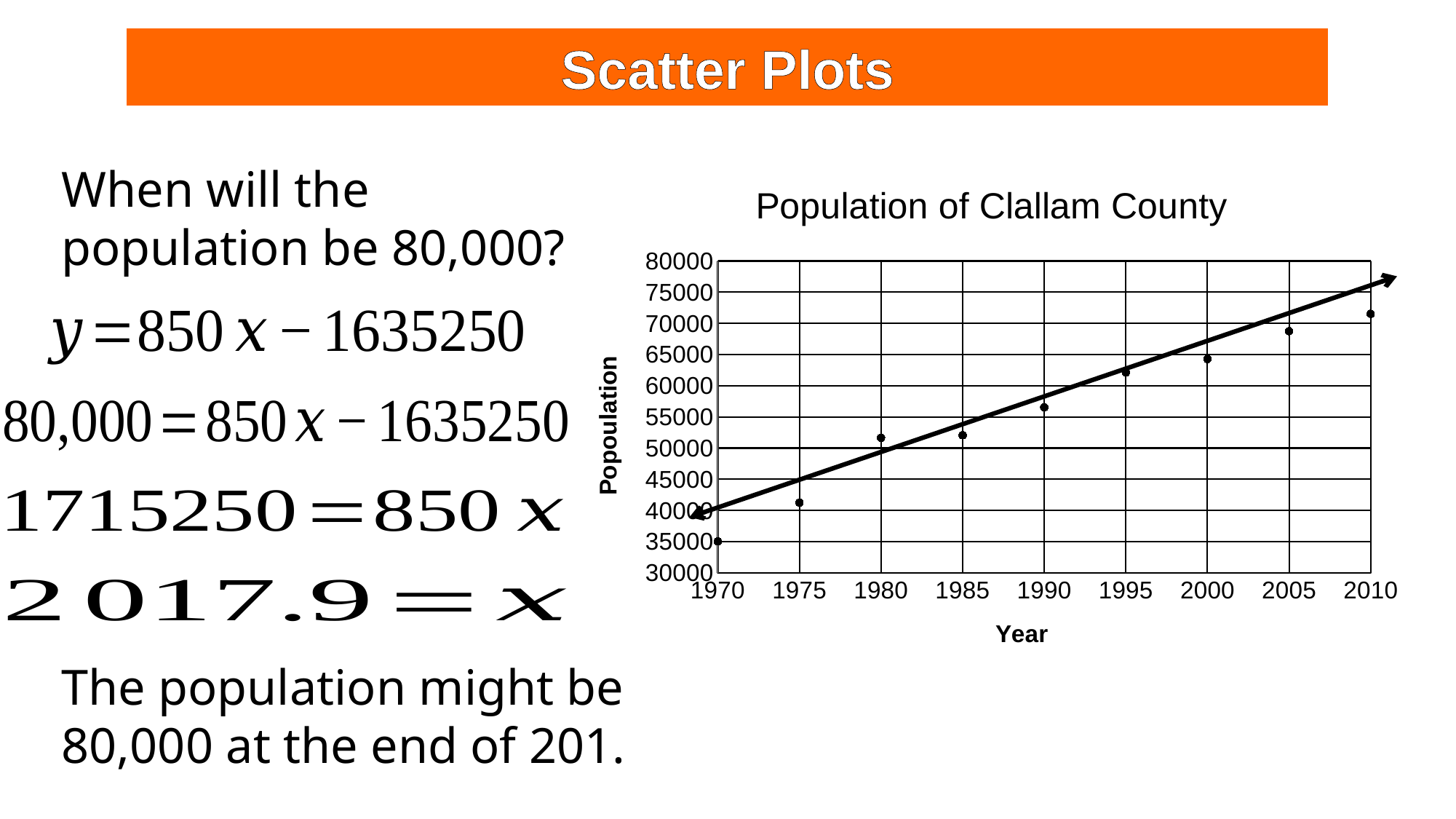
What is the title of the chart? Population of Clallam County Do the plotted population values rise or fall from 1970 to 2010? Rise What kind of chart is shown on the slide? Scatter plot How many data points are plotted on the chart? 9 What is the label of the x axis of the chart? Year Is the population value for 2010 greater or less than 70000? greater Is the population value for 1985 greater or less than 55000? less Is the population value for 1975 greater or less than 40000? greater Which year has the highest plotted population? 2010 Which year has the larger plotted population, 1990 or 2005? 2005 Which year has the lowest plotted population? 1970